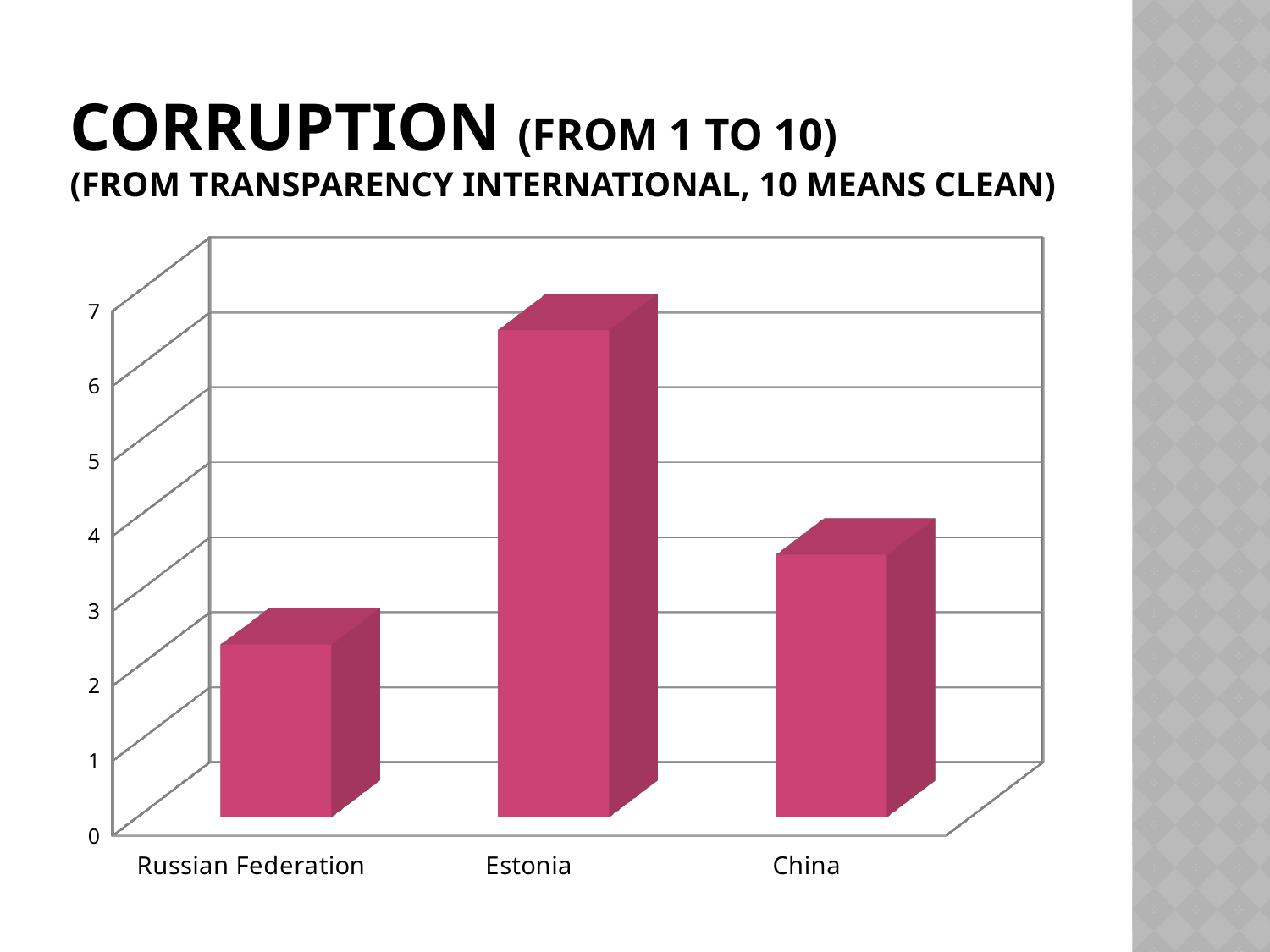
Is the value for China greater or less than 4? less What is the title of the chart on the slide? Corruption (from 1 to 10) How many countries are shown on the chart? 3 Which country has the highest corruption score on the chart? Estonia Which country has the lowest corruption score on the chart? Russian Federation Is the value for Estonia greater or less than 6? greater Is the value for the Russian Federation greater or less than 3? less Which has a higher value on the chart, China or the Russian Federation? China According to the slide subtitle, what does a score of 10 mean? clean What kind of chart is shown on the slide? bar chart Which has a higher value on the chart, Estonia or China? Estonia